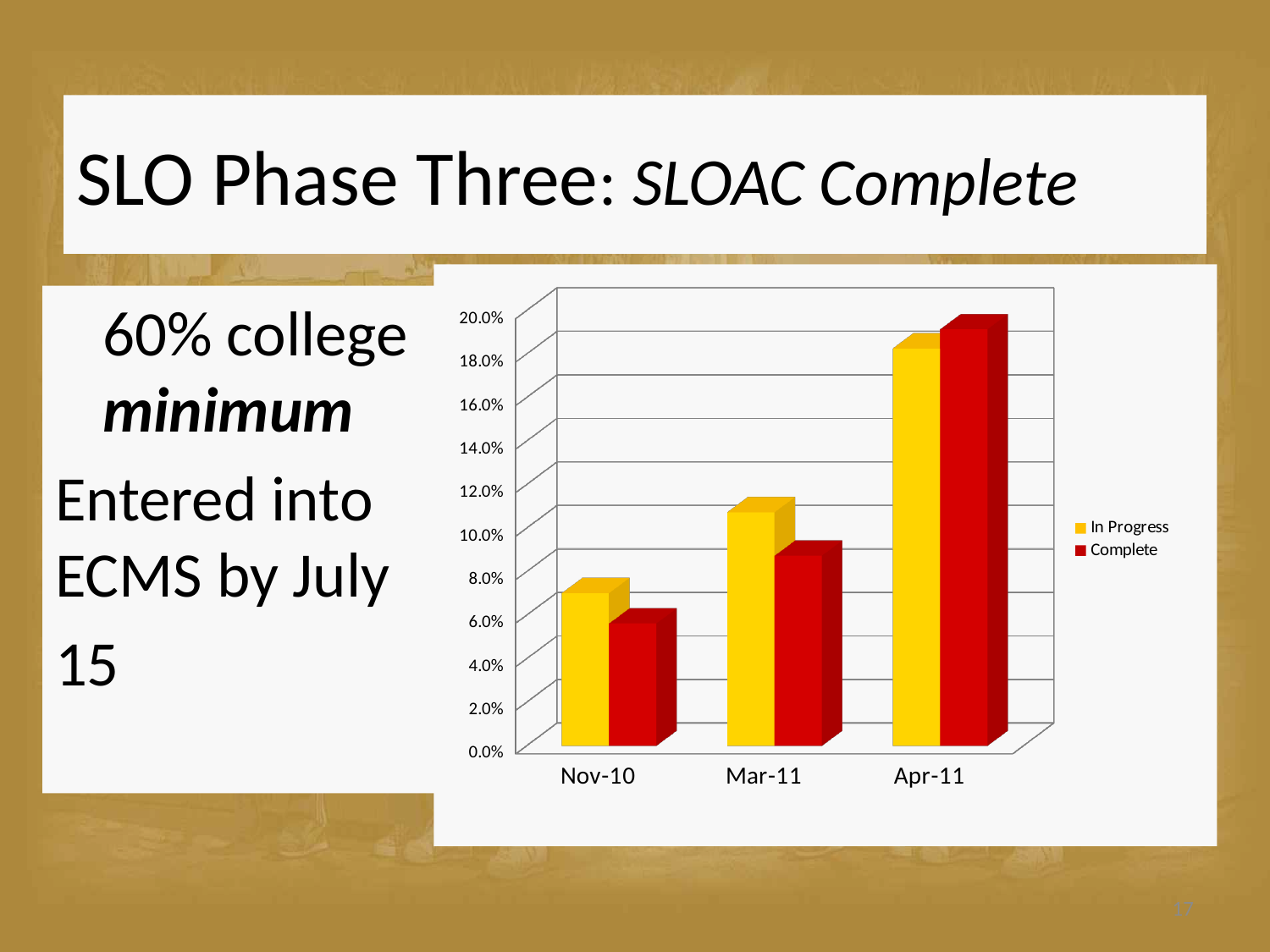
What kind of chart is shown on the slide? bar chart Do the Complete values rise or fall from Nov-10 to Apr-11? rise For Mar-11, which is larger: In Progress or Complete? In Progress Is the In Progress value for Nov-10 greater or less than 10.0%? less How many categories are shown on the x axis of the chart? 3 Which colour represents the Complete series in the chart? red Is the Complete value for Mar-11 greater or less than 12.0%? less Is the Complete value for Apr-11 greater or less than 16.0%? greater Which category has the highest In Progress value? Apr-11 Which category has the lowest Complete value? Nov-10 How many series does the chart legend list? 2